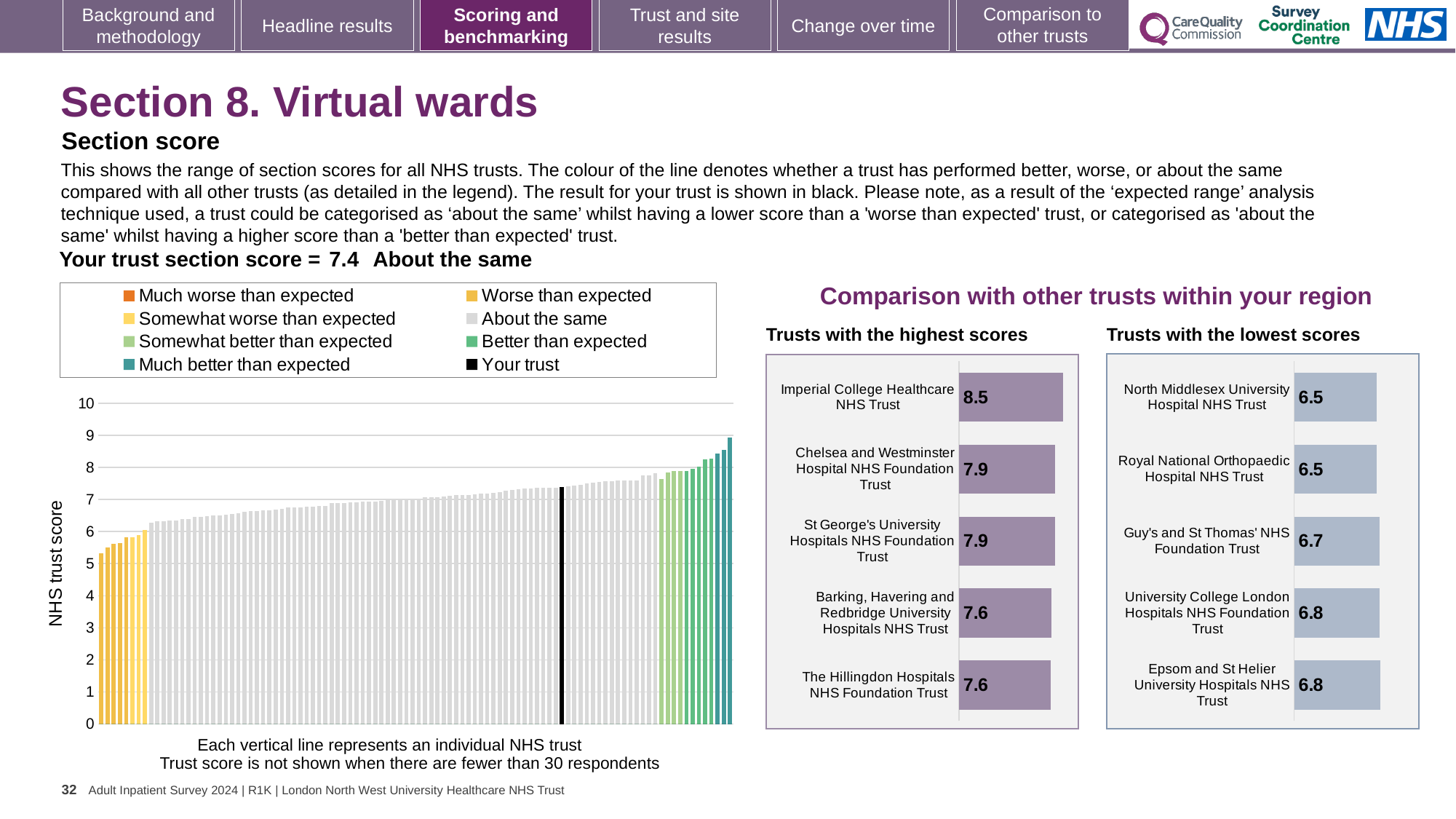
On the 'Trusts with the lowest scores' chart, what is the difference between the scores of Epsom and St Helier University Hospitals NHS Trust and North Middlesex University Hospital NHS Trust? 0.3 How many entries does the legend of the main NHS trust score chart on the left list? 8 On the 'Trusts with the highest scores' chart, how many trusts are shown? 5 On the main NHS trust score chart on the left, do the bar values rise or fall from left to right along the x axis? rise On the 'Trusts with the highest scores' chart, what is the score for Imperial College Healthcare NHS Trust? 8.5 On the 'Trusts with the lowest scores' chart, what is the score for Guy's and St Thomas' NHS Foundation Trust? 6.7 On the 'Trusts with the lowest scores' chart, what is the score for North Middlesex University Hospital NHS Trust? 6.5 On the 'Trusts with the lowest scores' chart, which has the larger score: University College London Hospitals NHS Foundation Trust or Royal National Orthopaedic Hospital NHS Trust? University College London Hospitals NHS Foundation Trust On the 'Trusts with the highest scores' chart, what is the score for The Hillingdon Hospitals NHS Foundation Trust? 7.6 On the 'Trusts with the highest scores' chart, what is the difference between the scores of Imperial College Healthcare NHS Trust and Barking, Havering and Redbridge University Hospitals NHS Trust? 0.9 On the 'Trusts with the highest scores' chart, which trust has the highest score? Imperial College Healthcare NHS Trust On the main NHS trust score chart on the left, what is the section score for your trust (the black bar)? 7.4